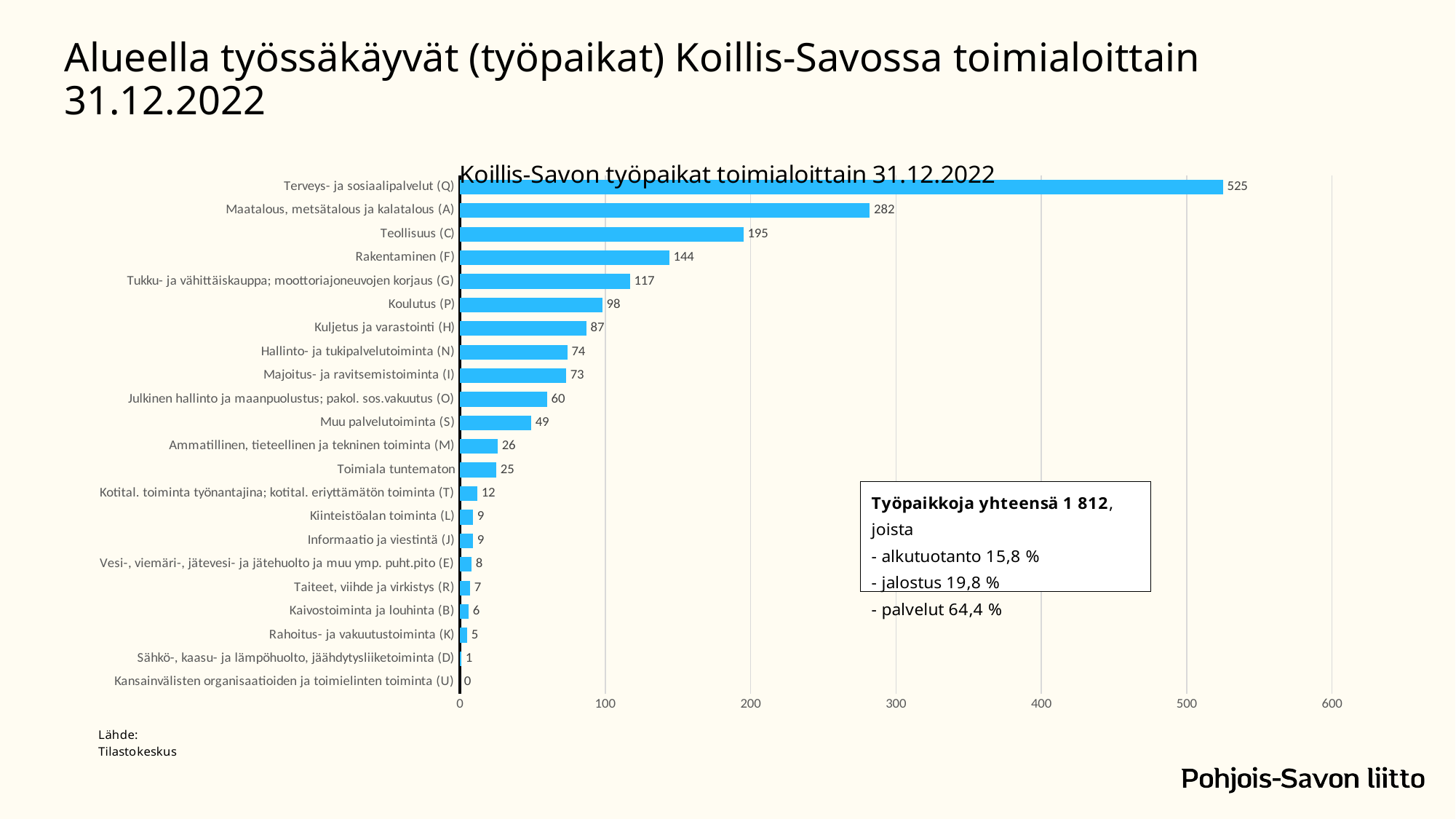
What is the value for Muu palvelutoiminta (S)? 49 What is the difference between Maatalous, metsätalous ja kalatalous (A) and Teollisuus (C)? 87 Which category has the lowest value? Kansainvälisten organisaatioiden ja toimielinten toiminta (U) Which category has the highest value? Terveys- ja sosiaalipalvelut (Q) What is the title of the chart? Koillis-Savon työpaikat toimialoittain 31.12.2022 Is the value for Tukku- ja vähittäiskauppa; moottoriajoneuvojen korjaus (G) greater or less than 100? greater What is the value for Koulutus (P)? 98 Which is larger, Kuljetus ja varastointi (H) or Hallinto- ja tukipalvelutoiminta (N)? Kuljetus ja varastointi (H) How many categories are shown in the chart? 22 What is the value for Rakentaminen (F)? 144 What kind of chart is shown? Bar chart What is the value for Terveys- ja sosiaalipalvelut (Q)? 525